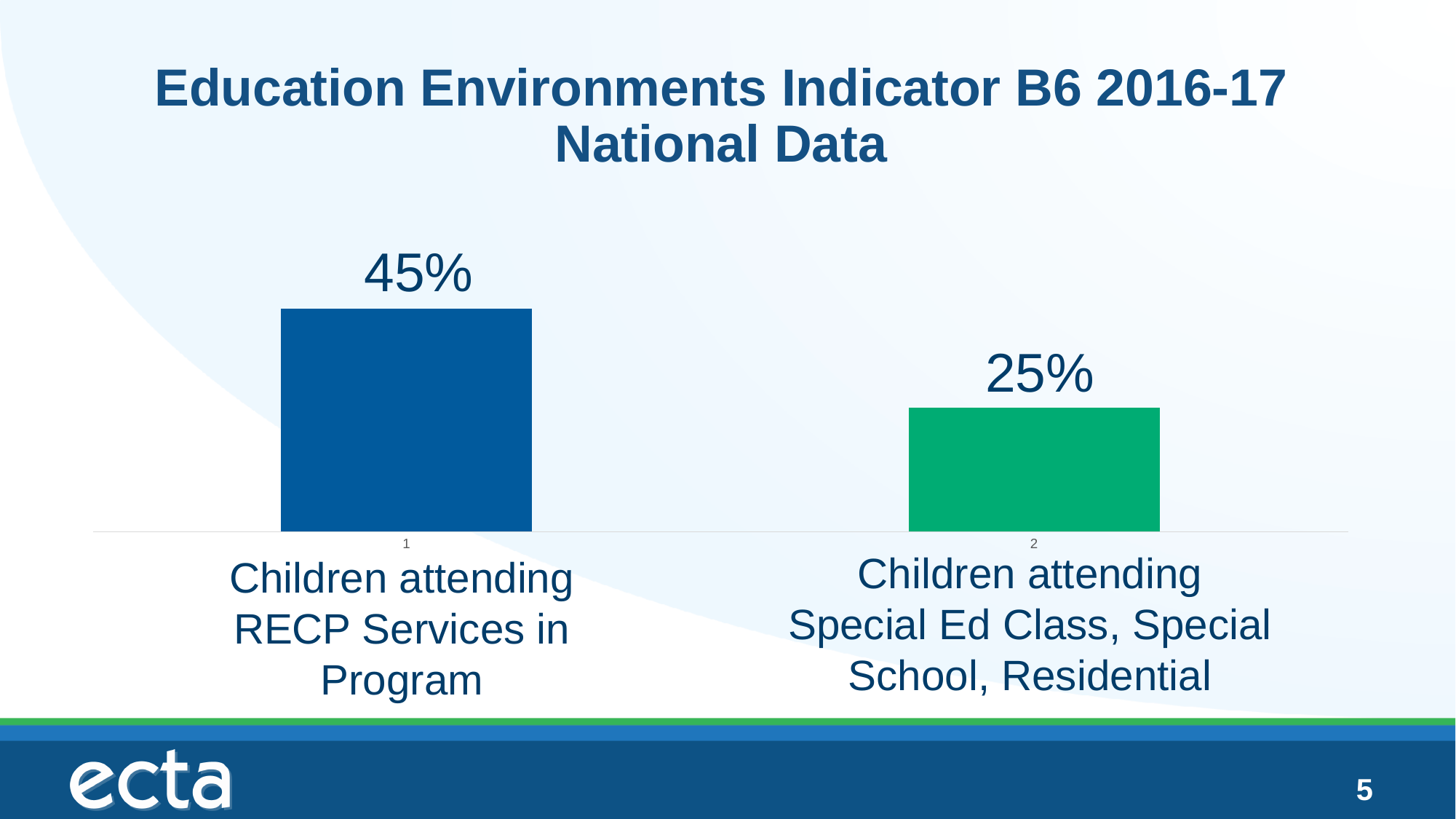
Which is larger: the value for Children attending RECP Services in Program or the value for Children attending Special Ed Class, Special School, Residential? Children attending RECP Services in Program Do the values rise or fall from left to right across the chart? Fall Which category has the lowest value? Children attending Special Ed Class, Special School, Residential What is the value for Children attending RECP Services in Program? 45% How many categories are shown in the chart? 2 What is the title of the slide containing the chart? Education Environments Indicator B6 2016-17 National Data What is the difference between the value for Children attending RECP Services in Program and the value for Children attending Special Ed Class, Special School, Residential? 20% Which category has the highest value? Children attending RECP Services in Program What colour is the bar for Children attending Special Ed Class, Special School, Residential? Green What kind of chart is shown on the slide? Bar chart What is the value for Children attending Special Ed Class, Special School, Residential? 25%